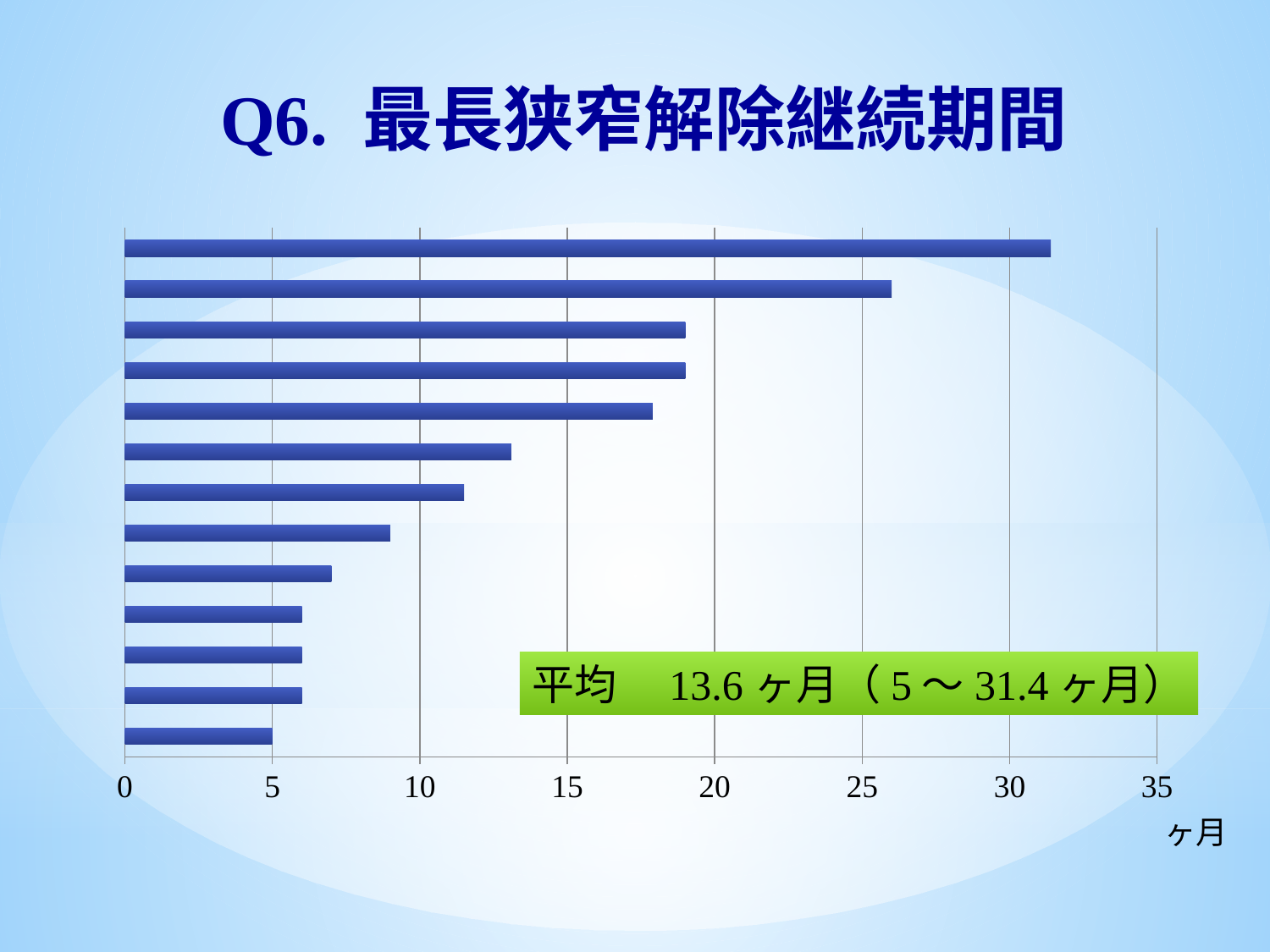
Is the value of the bottom bar greater or less than 10? less How many bars are plotted in the chart? 13 Is the value of the second bar from the top greater or less than 25? greater Do the bar values increase or decrease going from the top of the chart to the bottom? decrease Which bar is longer, the top bar or the bottom bar? the top bar What kind of chart is shown on the slide? bar chart According to the text box on the chart, what is the shortest value among the bars? 5 ヶ月 Is the value of the top bar greater or less than 30? greater What unit is shown at the end of the horizontal axis? ヶ月 What average value is stated in the green text box on the chart? 13.6 ヶ月 According to the text box on the chart, what is the longest value among the bars? 31.4 ヶ月 What is the title of the chart on the slide? Q6. 最長狭窄解除継続期間